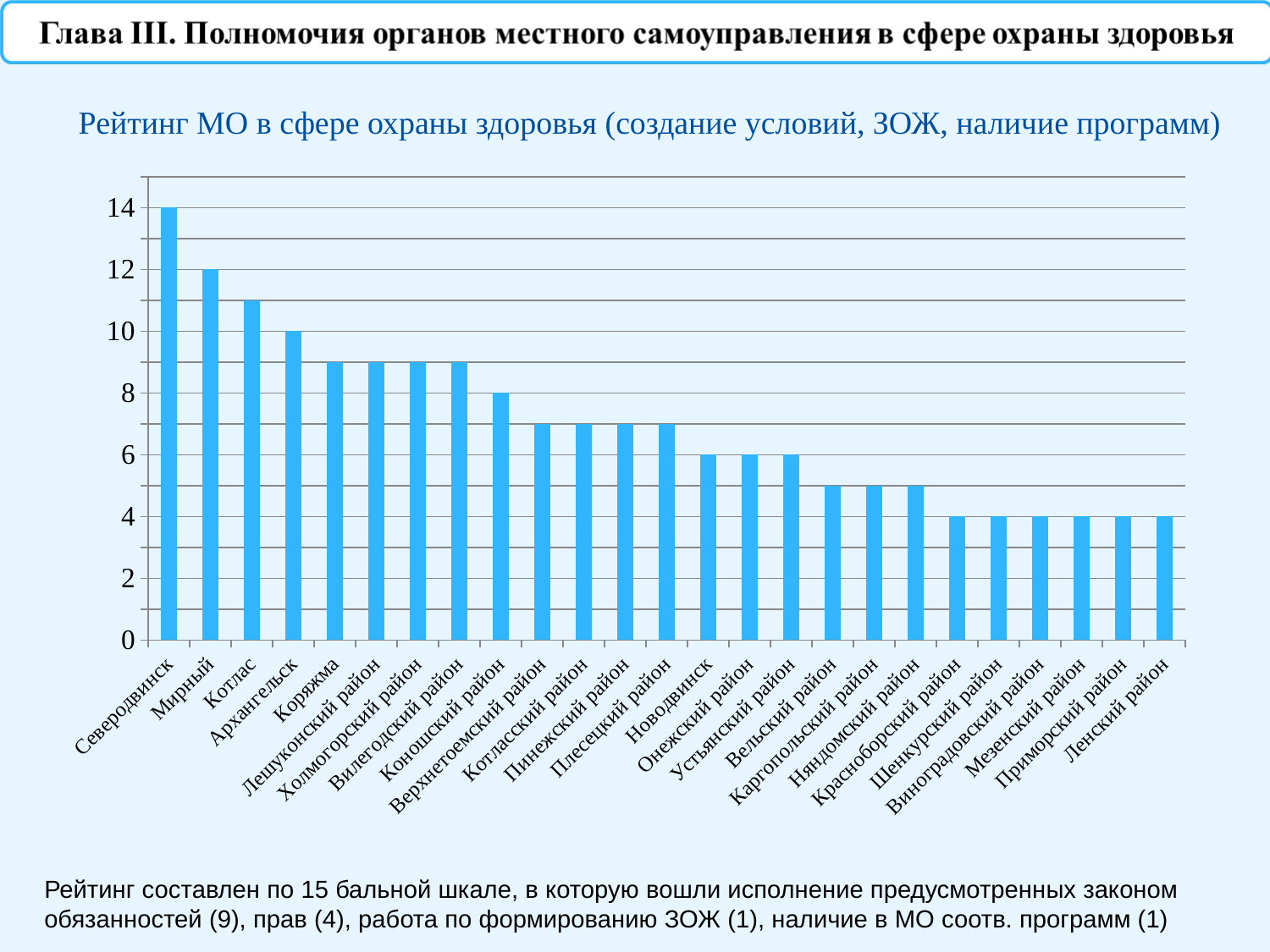
What type of chart is shown on the slide? Bar chart Which has a higher rating, Мирный or Архангельск? Мирный What is the rating value for Северодвинск? 14 Is the value for Вельский район greater or less than 6? less What is the rating value for Мирный? 12 Which municipality has the highest rating in the chart? Северодвинск What is the rating value for Архангельск? 10 Is the value for Котлас greater or less than 10? greater Do the values rise or fall from left to right along the x axis? Fall How many municipalities are shown in the chart? 25 What is the rating value for Коношский район? 8 What is the difference between the ratings of Северодвинск and Мирный? 2